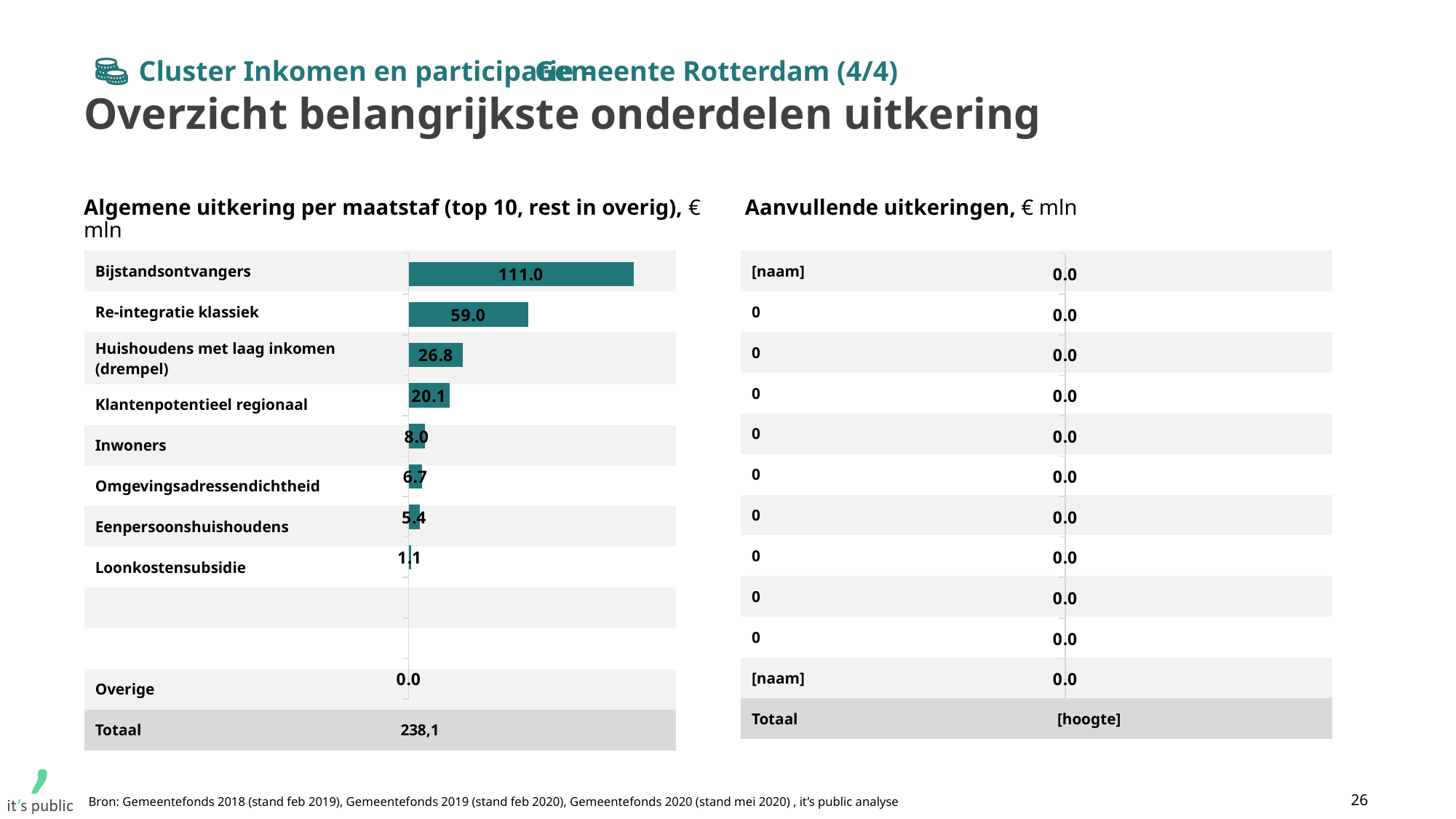
What kind of chart is 'Algemene uitkering per maatstaf'? Bar chart In the chart 'Algemene uitkering per maatstaf', what is the difference between Bijstandsontvangers and Re-integratie klassiek? 52.0 In the chart 'Algemene uitkering per maatstaf', which category has the highest value? Bijstandsontvangers In the chart 'Algemene uitkering per maatstaf', how many named maatstaf categories (excluding Overige and Totaal) are listed? 8 In the chart 'Algemene uitkering per maatstaf', what is the value for Bijstandsontvangers? 111.0 In the chart 'Algemene uitkering per maatstaf', which of the named maatstaf categories (excluding Overige) has the lowest value? Loonkostensubsidie In the chart 'Algemene uitkering per maatstaf', what is the value for Klantenpotentieel regionaal? 20.1 In the chart 'Algemene uitkering per maatstaf', what is the value for Overige? 0.0 In the chart 'Algemene uitkering per maatstaf', what is the Totaal shown at the bottom? 238,1 In the chart 'Algemene uitkering per maatstaf', what is the value for Re-integratie klassiek? 59.0 In the chart 'Algemene uitkering per maatstaf', which is larger: Inwoners or Omgevingsadressendichtheid? Inwoners In the chart 'Algemene uitkering per maatstaf', what is the value for Huishoudens met laag inkomen (drempel)? 26.8